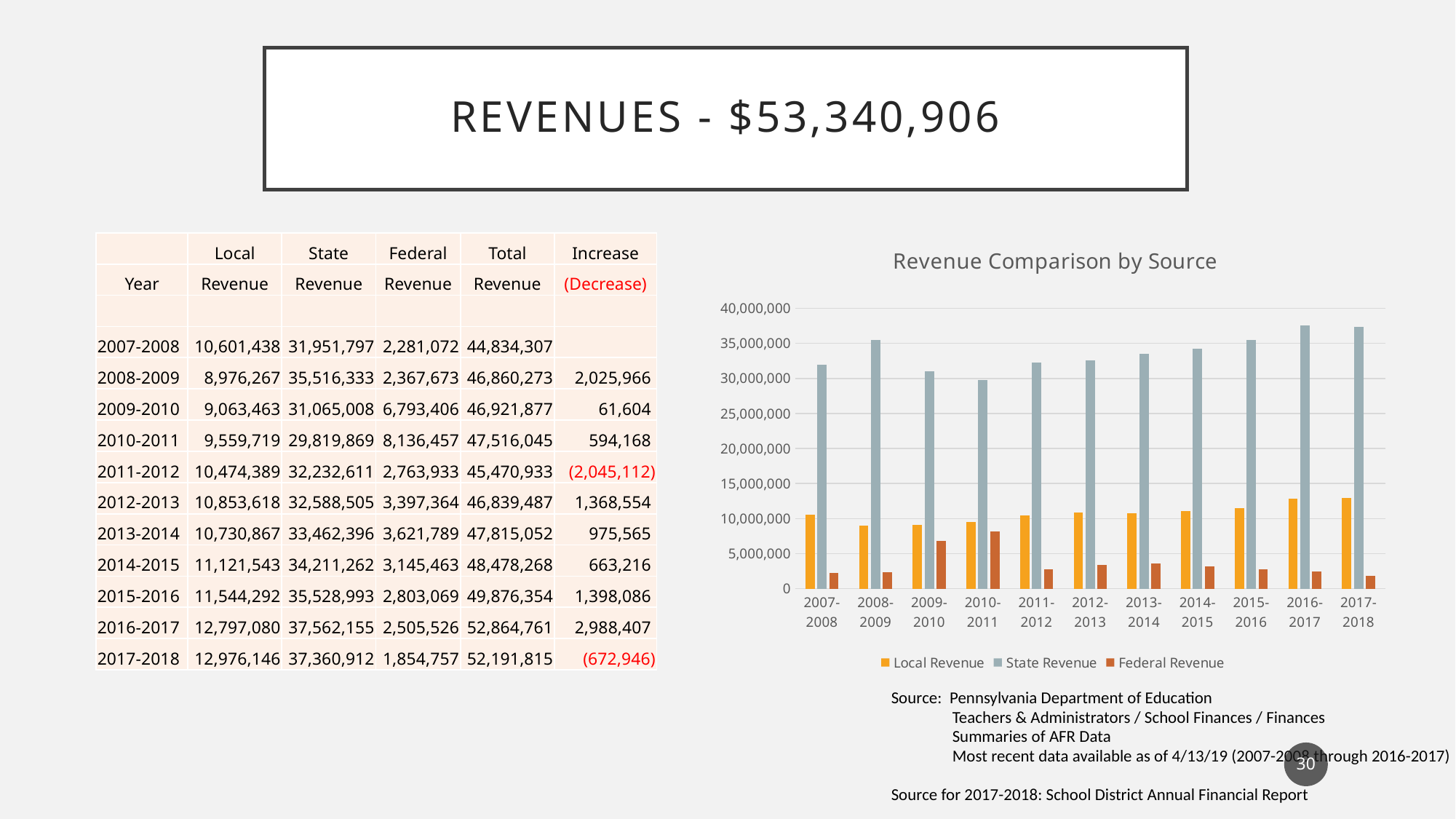
In which year is Federal Revenue lowest in the Revenue Comparison by Source chart? 2017-2018 Is the Federal Revenue for 2009-2010 greater or less than 5,000,000? greater What is the Federal Revenue for 2013-2014? 3,621,789 In which year is Federal Revenue highest in the Revenue Comparison by Source chart? 2010-2011 How many series does the legend of the Revenue Comparison by Source chart list? 3 How many school years are shown on the x axis of the Revenue Comparison by Source chart? 11 Does Local Revenue rise or fall from 2013-2014 to 2017-2018? rise What is the Local Revenue for 2017-2018? 12,976,146 What is the title of the chart on the right of the slide? Revenue Comparison by Source What is the difference between State Revenue in 2008-2009 and State Revenue in 2007-2008? 3,564,536 Which is larger in 2010-2011, Local Revenue or Federal Revenue? Local Revenue What kind of chart is the Revenue Comparison by Source chart? bar chart